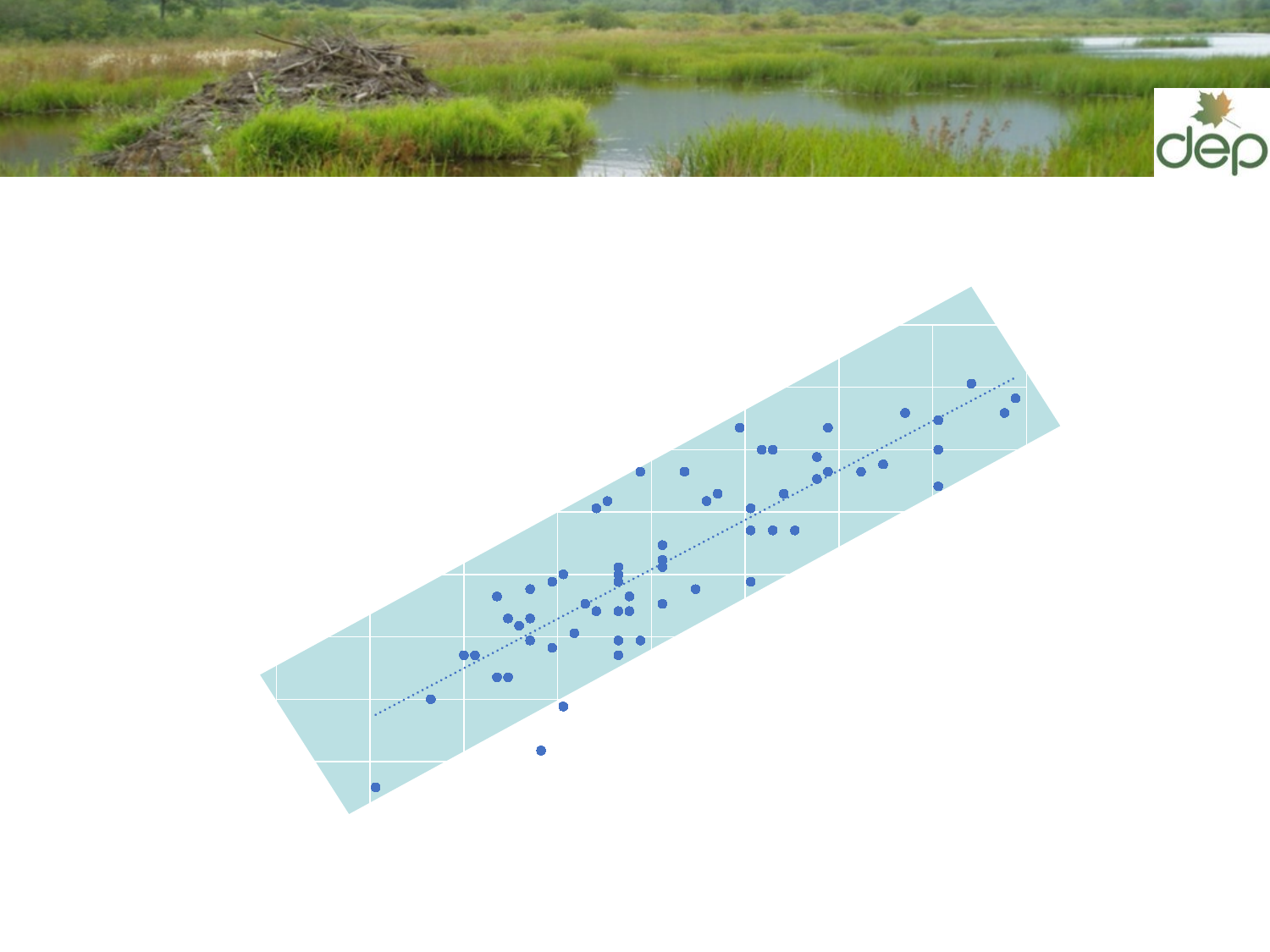
What kind of chart is shown on the slide? scatter chart Does the dotted trend line on the scatter chart slope upward or downward? upward What colour are the data points on the scatter chart? blue Is a trend line drawn through the points on the scatter chart? yes Do the plotted points generally rise or fall along the x axis? rise